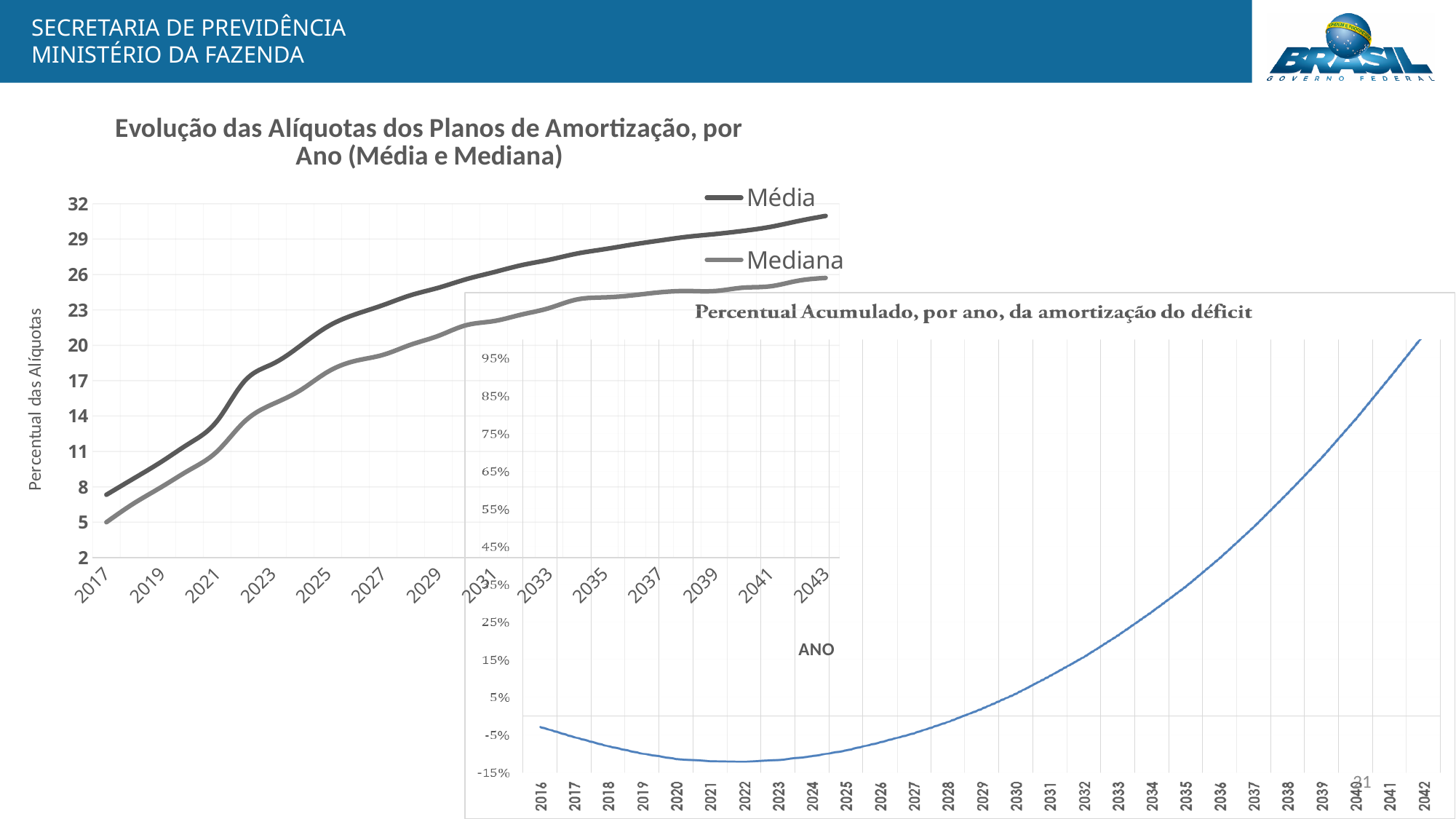
How many series does the legend list in the chart titled "Evolução das Alíquotas dos Planos de Amortização, por Ano (Média e Mediana)"? 2 In the chart titled "Percentual Acumulado, por ano, da amortização do déficit", is the value for 2022 greater or less than -5%? less In the chart titled "Evolução das Alíquotas dos Planos de Amortização, por Ano (Média e Mediana)", do the values of Média rise or fall from 2017 to 2043? rise In the chart titled "Percentual Acumulado, por ano, da amortização do déficit", do the values rise or fall from 2025 to 2042? rise In the chart titled "Evolução das Alíquotas dos Planos de Amortização, por Ano (Média e Mediana)", which series is higher in 2030, Média or Mediana? Média In the chart titled "Percentual Acumulado, por ano, da amortização do déficit", which year has the highest value? 2042 What kind of chart is the chart titled "Evolução das Alíquotas dos Planos de Amortização, por Ano (Média e Mediana)"? line chart In the chart titled "Evolução das Alíquotas dos Planos de Amortização, por Ano (Média e Mediana)", is the value of Média in 2043 greater or less than 29? greater What kind of chart is the chart titled "Percentual Acumulado, por ano, da amortização do déficit"? line chart In the chart titled "Evolução das Alíquotas dos Planos de Amortização, por Ano (Média e Mediana)", is the value of Mediana in 2021 greater or less than 14? less What is the y-axis label of the chart titled "Evolução das Alíquotas dos Planos de Amortização, por Ano (Média e Mediana)"? Percentual das Alíquotas